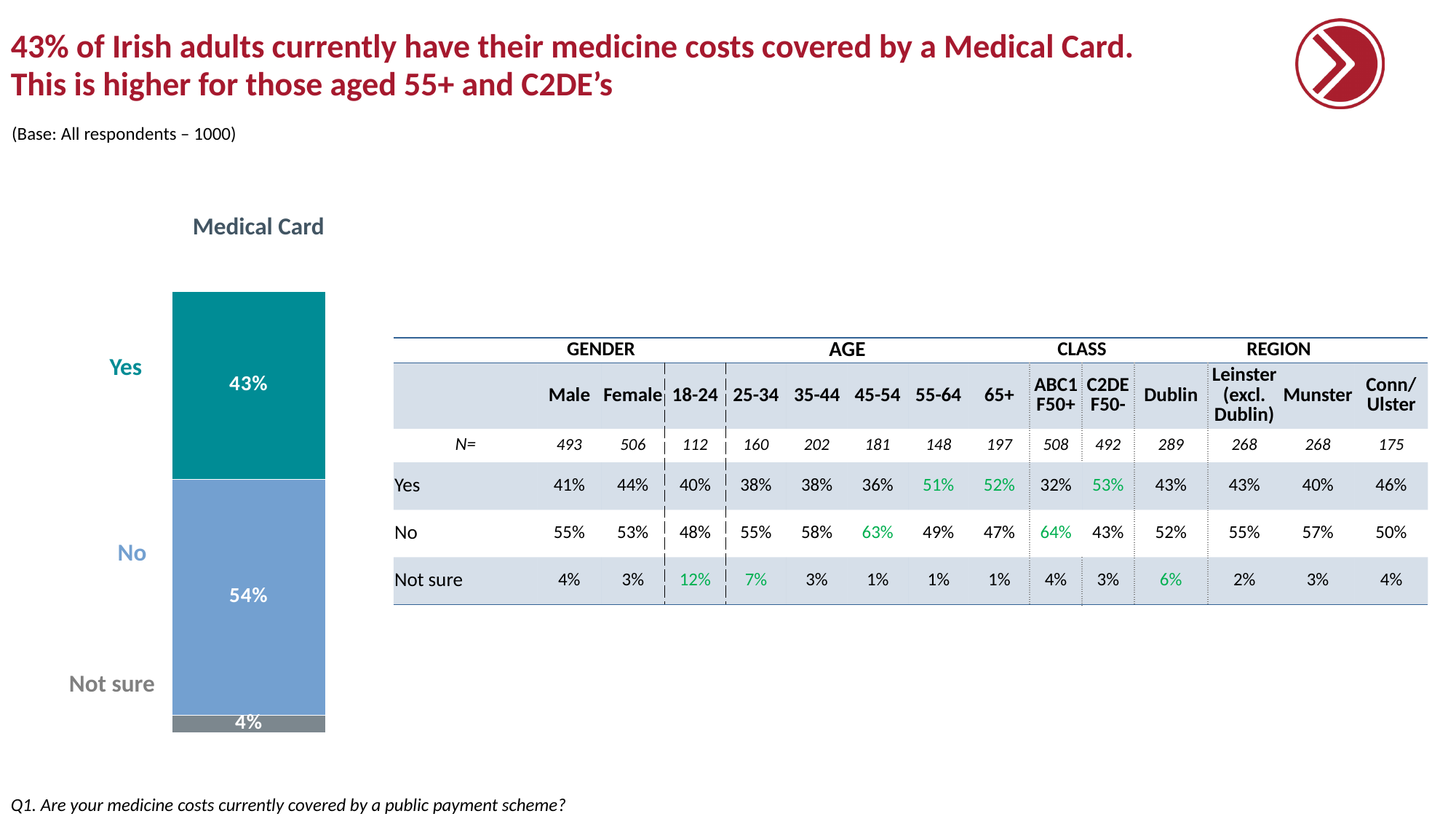
What colour is the Yes segment in the Medical Card chart? Teal Which response has the smallest segment in the Medical Card chart? Not sure In the Medical Card chart, what percentage answered No? 54% In the Medical Card chart, what is the difference between the Yes and Not sure percentages? 39% Which response has the largest segment in the Medical Card chart? No In the Medical Card chart, what percentage answered Yes? 43% In the Medical Card chart, which is larger, Yes or No? No What is the title of the chart on the slide? Medical Card In the Medical Card chart, what is the difference between the No and Yes percentages? 11% How many response categories are shown in the Medical Card chart? 3 What kind of chart is the Medical Card chart? Stacked bar chart In the Medical Card chart, what percentage answered Not sure? 4%